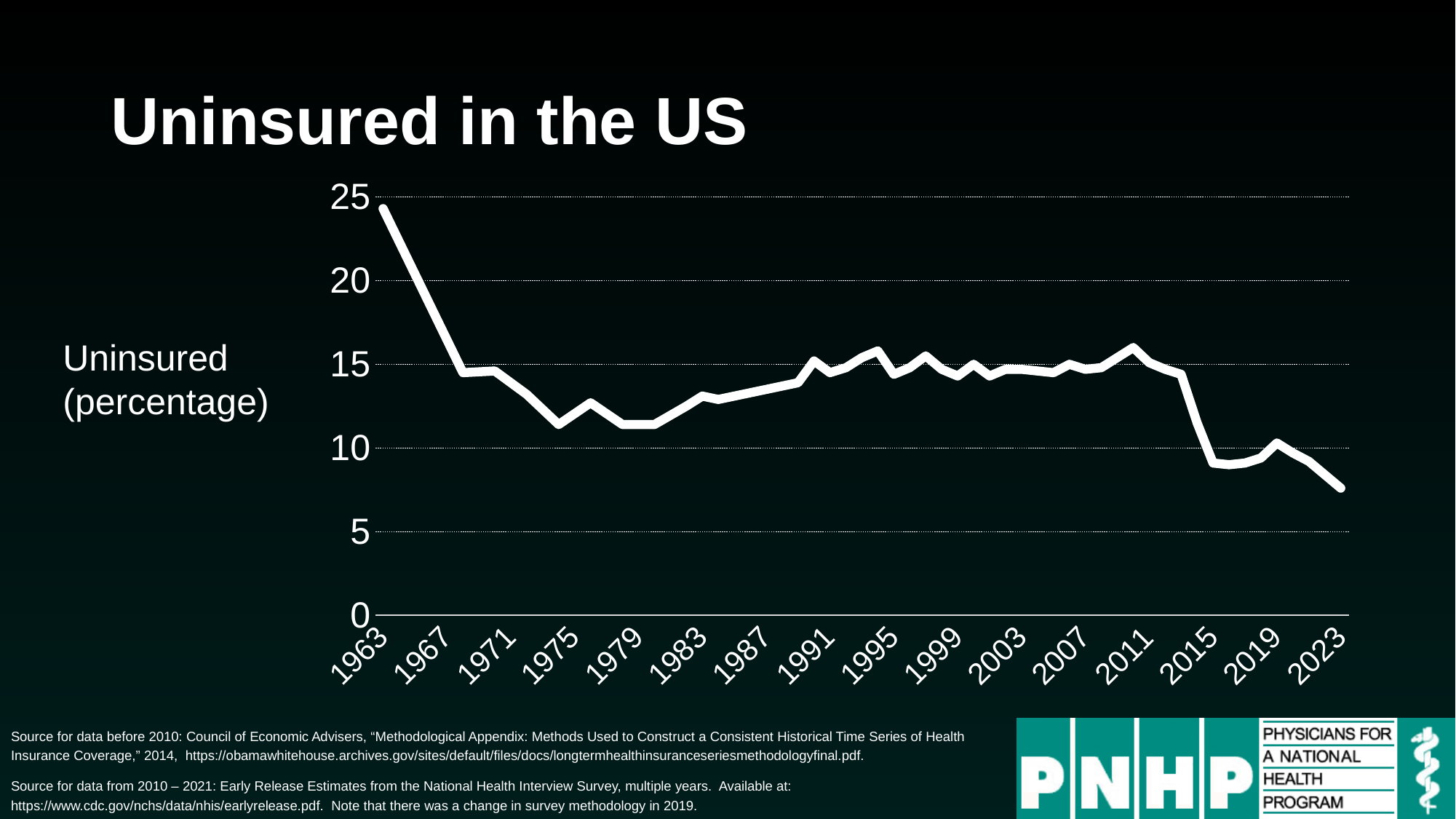
What does the y axis of the chart measure, according to its label? Uninsured (percentage) Which year on the x axis has the lowest uninsured percentage? 2023 Is the value for 2015 greater or less than 10? less Which year on the x axis has the highest uninsured percentage? 1963 Is the value for 1975 greater or less than 15? less How many year labels are shown on the x axis? 16 Is the value for 1979 greater or less than 10? greater Does the uninsured percentage rise or fall between 2011 and 2015? fall What is the title of the chart? Uninsured in the US What kind of chart is shown on the slide? line chart